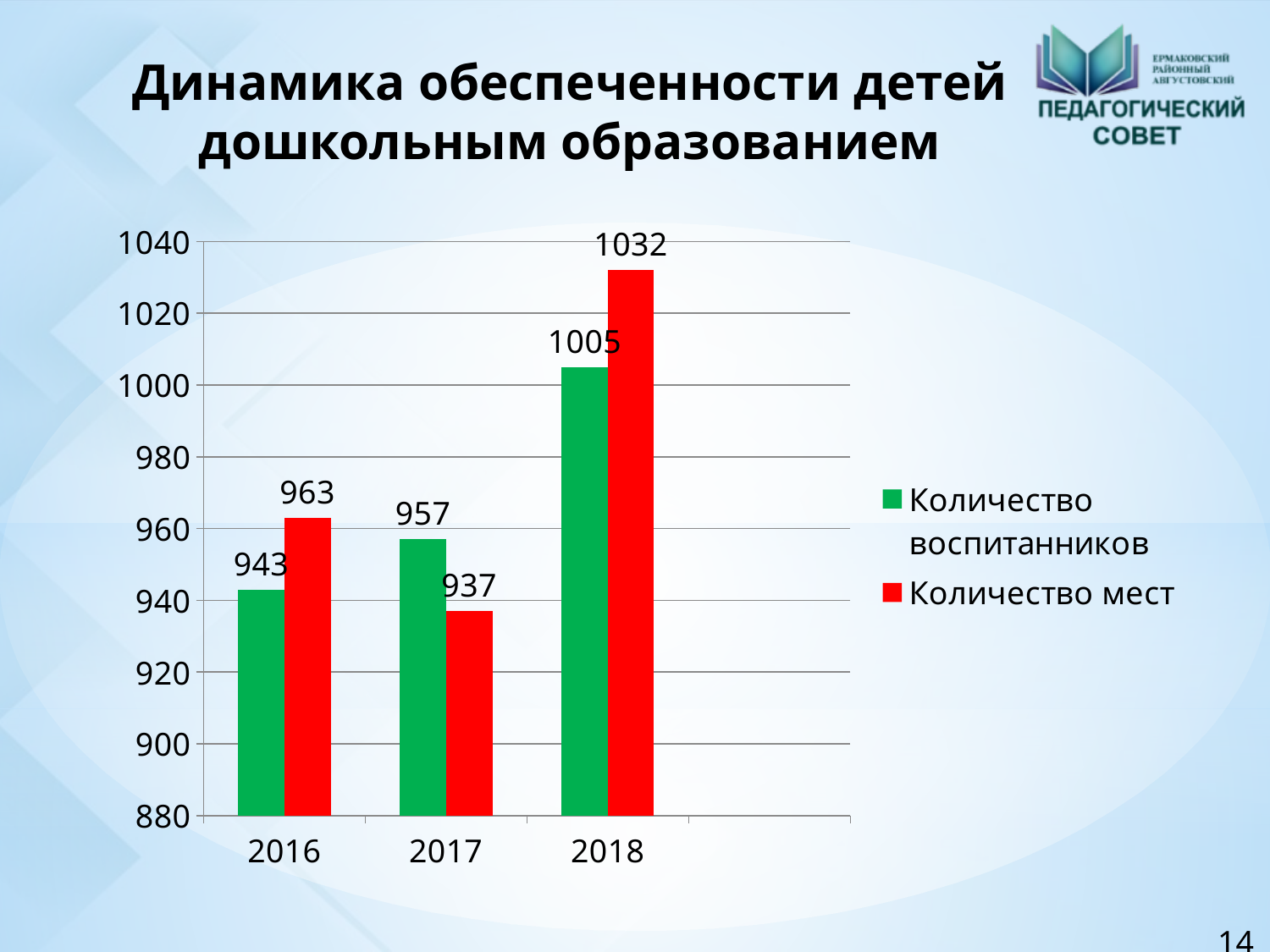
How many years are shown on the x axis? 3 Is the value of Количество воспитанников for 2018 greater or less than 1000? greater What is the value of Количество мест for 2017? 937 Does Количество воспитанников rise or fall from 2016 to 2018? rise How many series does the legend list? 2 What is the value of Количество мест for 2018? 1032 What kind of chart is shown on the slide? bar chart What is the difference between Количество мест and Количество воспитанников in 2018? 27 In which year is Количество воспитанников highest? 2018 In which year is Количество мест lowest? 2017 Which is larger in 2017, Количество воспитанников or Количество мест? Количество воспитанников What is the value of Количество воспитанников for 2016? 943